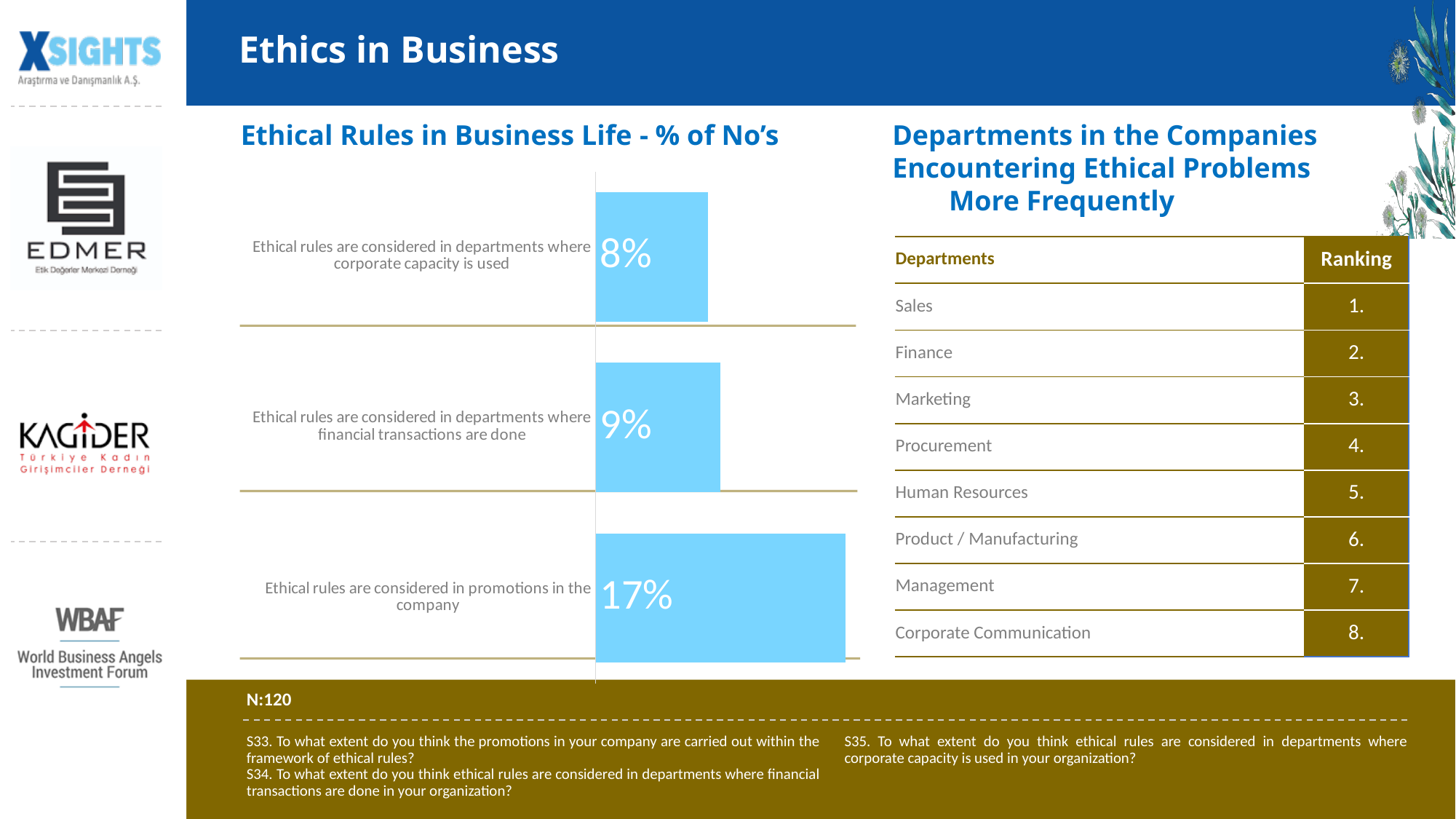
What is the difference between the value for departments where financial transactions are done and the value for departments where corporate capacity is used? 1% Which category has the highest % of No's? Ethical rules are considered in promotions in the company What is the difference between the value for promotions in the company and the value for departments where corporate capacity is used? 9% What colour are the bars in the chart? Light blue What is the value for 'Ethical rules are considered in promotions in the company'? 17% What kind of chart is shown on the slide? Bar chart Which is larger: the value for promotions in the company or the value for departments where financial transactions are done? Promotions in the company What is the value for 'Ethical rules are considered in departments where financial transactions are done'? 9% What is the value for 'Ethical rules are considered in departments where corporate capacity is used'? 8% What is the title of the chart? Ethical Rules in Business Life - % of No's Which category has the lowest % of No's? Ethical rules are considered in departments where corporate capacity is used How many categories are shown in the bar chart? 3